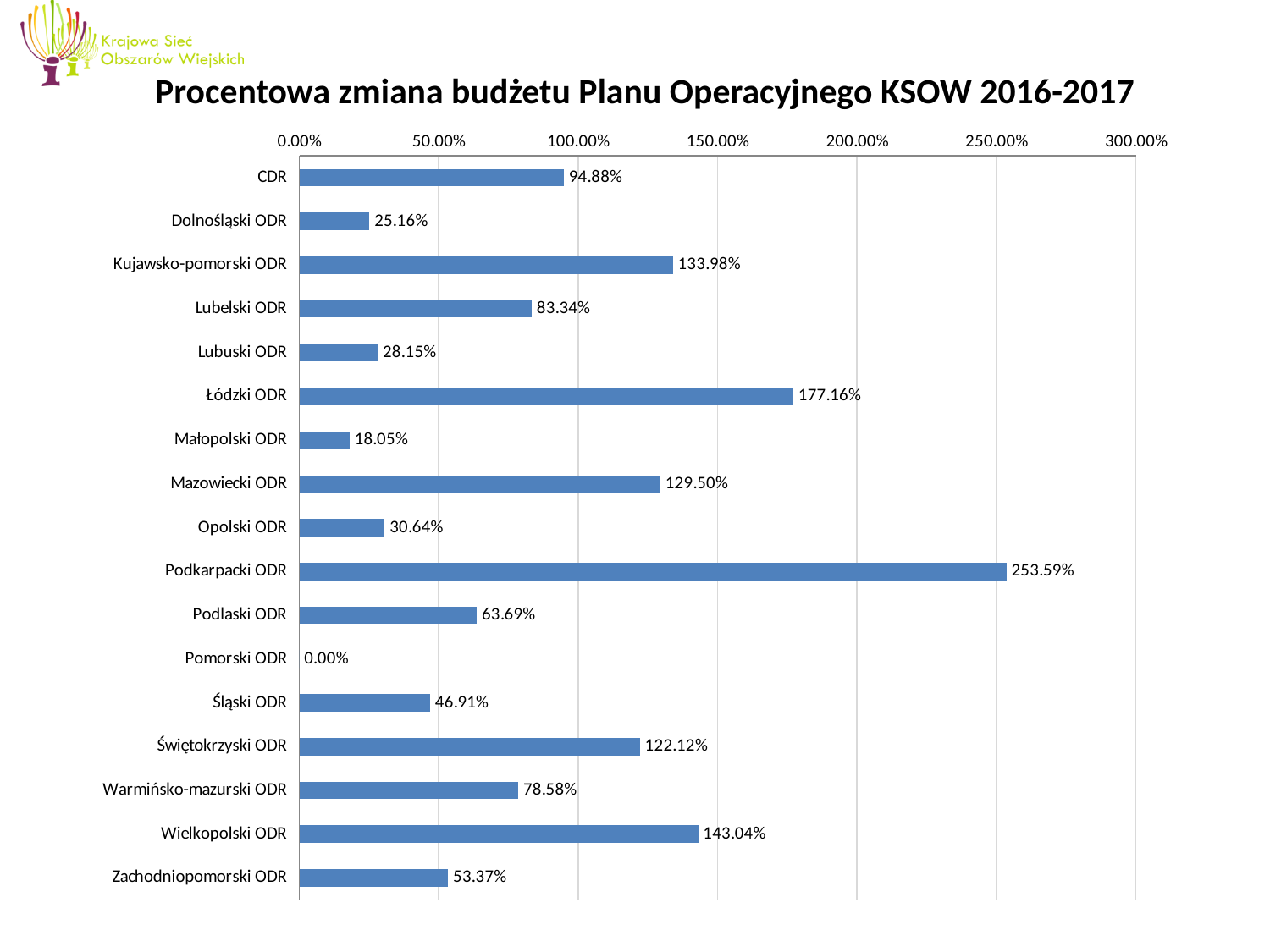
What is the title of the chart? Procentowa zmiana budżetu Planu Operacyjnego KSOW 2016-2017 What is the difference between the values for Wielkopolski ODR and Kujawsko-pomorski ODR? 9.06% Which is larger, the value for Lubelski ODR or the value for Warmińsko-mazurski ODR? Lubelski ODR What is the difference between the values for Łódzki ODR and Mazowiecki ODR? 47.66% What is the value for CDR? 94.88% What is the value for Małopolski ODR? 18.05% What kind of chart is shown on the slide? Bar chart What is the value for Podkarpacki ODR? 253.59% Which category has the highest value? Podkarpacki ODR What is the value for Łódzki ODR? 177.16% How many categories are shown in the chart? 17 Which category has the lowest value? Pomorski ODR